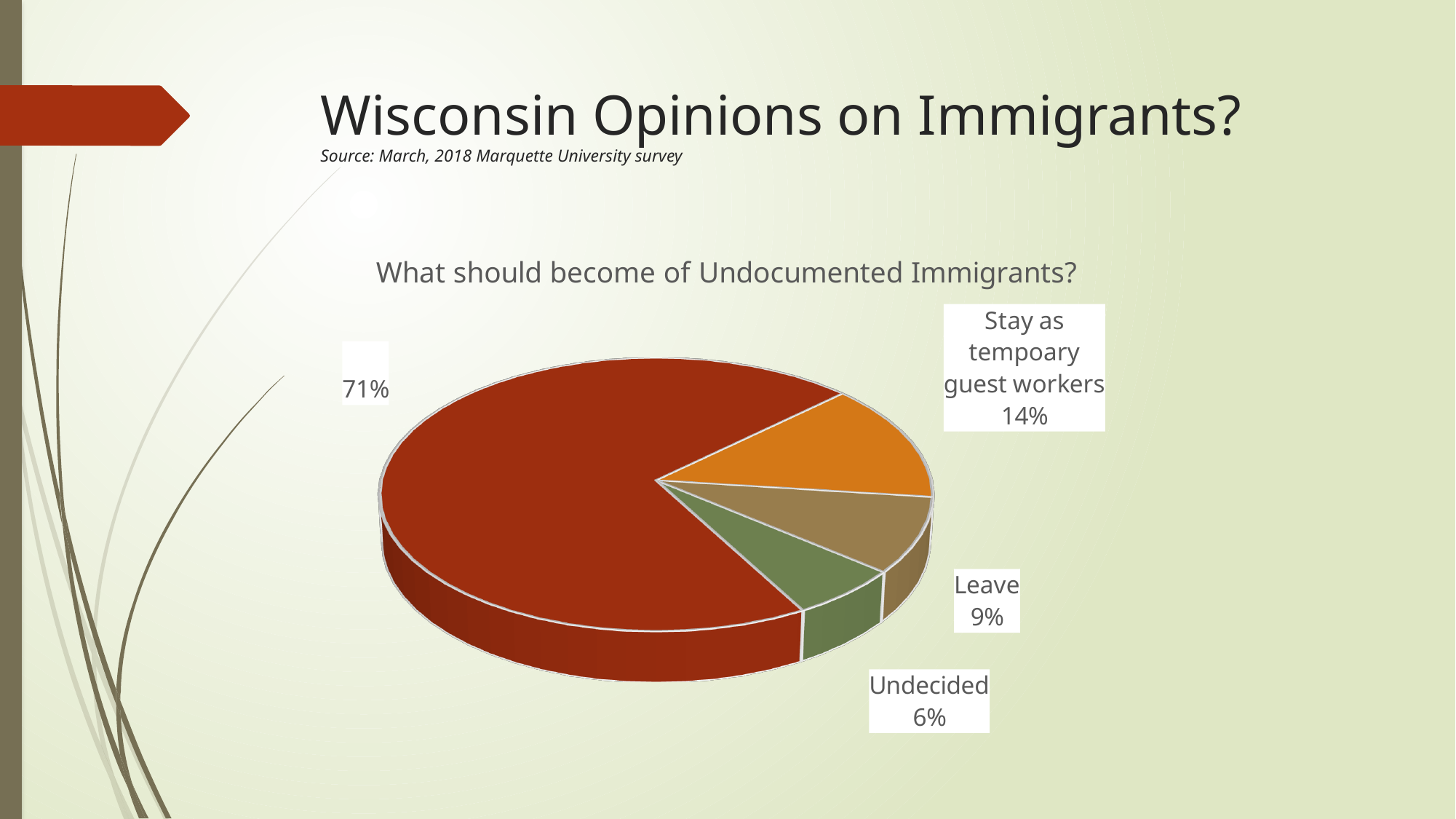
What percentage of respondents said undocumented immigrants should leave? 9% What percentage of respondents were undecided? 6% Which labelled category has the smallest slice in the pie chart? Undecided What is the source cited for the chart data? March, 2018 Marquette University survey What is the share of the largest slice in the pie chart? 71% What percentage of respondents said undocumented immigrants should stay as temporary guest workers? 14% How many slices does the pie chart have? 4 What kind of chart is shown on the slide? Pie chart What is the title of the chart? What should become of Undocumented Immigrants? What is the difference in percentage points between 'Stay as temporary guest workers' and 'Leave'? 5 Which is larger: the share for 'Leave' or the share for 'Undecided'? Leave What is the difference in percentage points between the largest slice (71%) and 'Undecided'? 65